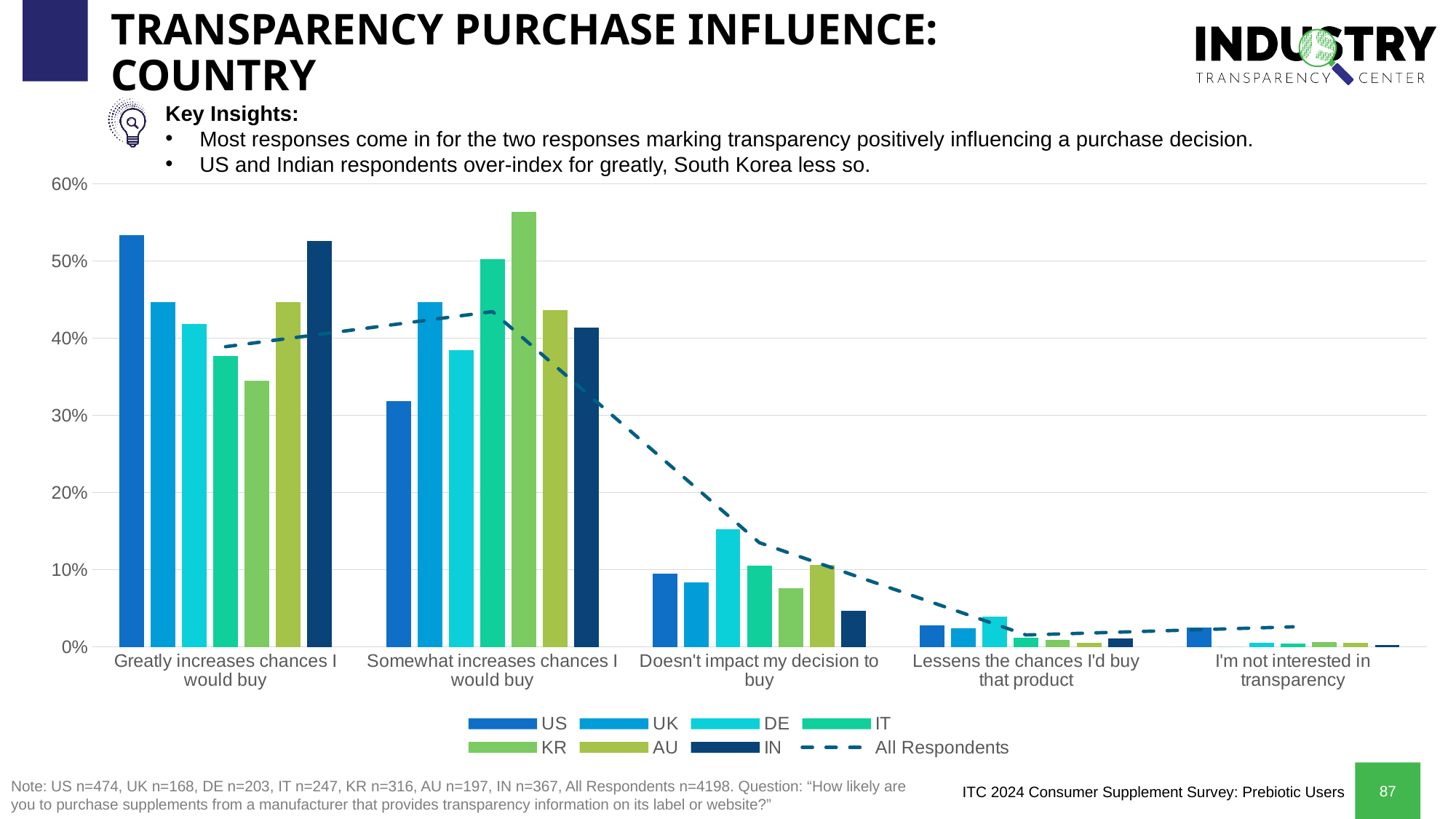
Which country has the lowest bar in "Doesn't impact my decision to buy"? IN Which country has the highest bar in "Somewhat increases chances I would buy"? KR In "Doesn't impact my decision to buy", which is larger, DE or IN? DE Is the value for IN in "Greatly increases chances I would buy" greater or less than 50%? greater What does the dashed line in the chart represent? All Respondents What kind of chart is shown on the slide? combination bar and line chart Is the value for DE in "Doesn't impact my decision to buy" greater or less than 10%? greater How many response categories are shown along the x axis? 5 Is the value for KR in "Somewhat increases chances I would buy" greater or less than 50%? greater How many series does the legend list? 8 Which country has the lowest bar in "Greatly increases chances I would buy"? KR